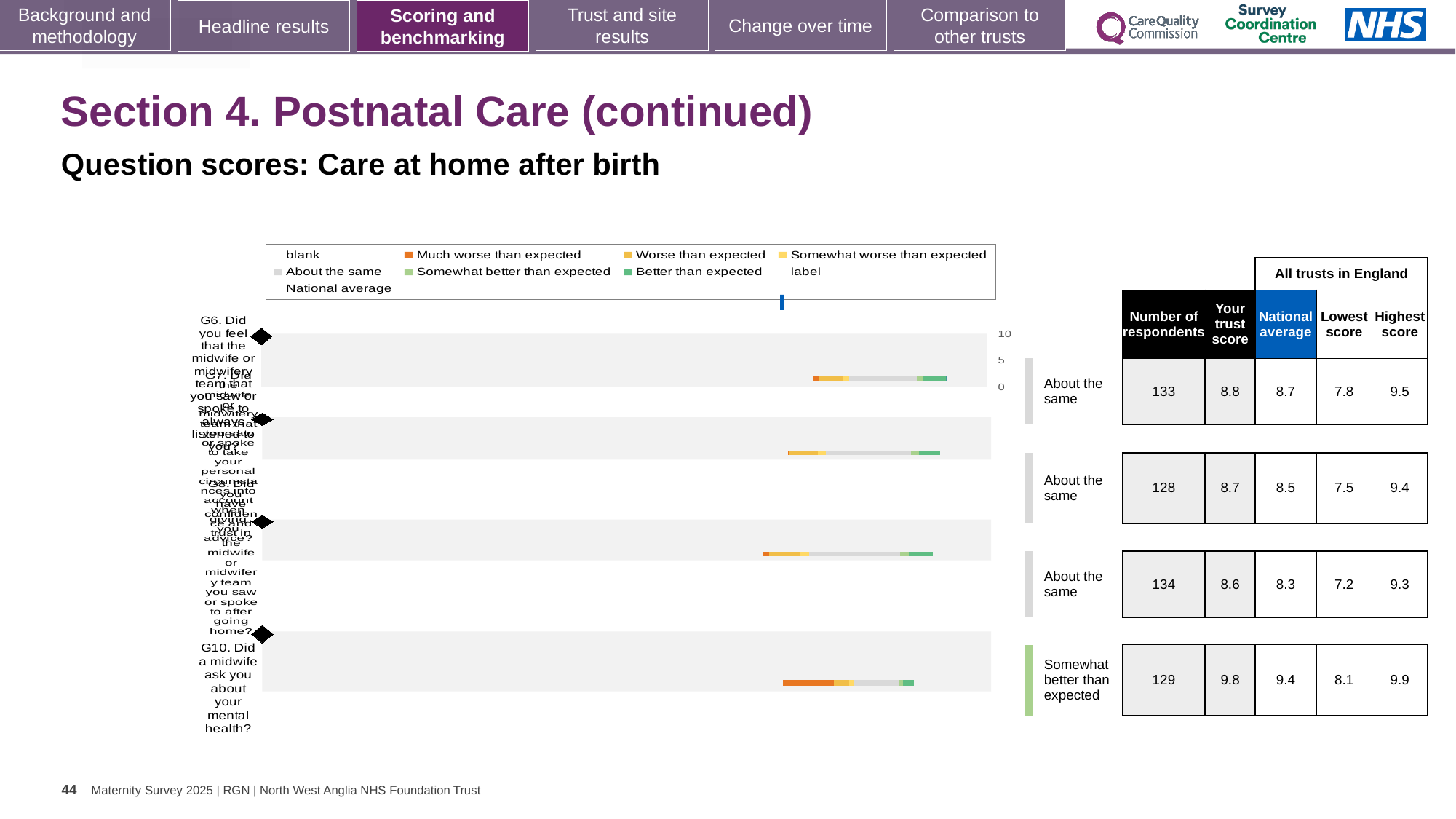
What is the trust score for G10 'Did a midwife ask you about your mental health?' 9.8 How many respondents answered G10 'Did a midwife ask you about your mental health?' 129 What type of chart is shown on the slide? bar chart What is the national average for G10 'Did a midwife ask you about your mental health?' 9.4 Which question is rated 'Somewhat better than expected'? G10. Did a midwife ask you about your mental health? What is the maximum value shown on the chart's score axis? 10 How many question bars are plotted in the chart? 4 Is the trust score for G10 (mental health) larger or smaller than its national average? larger What colour in the legend represents 'Much worse than expected'? orange By how much does the trust score for G10 (mental health) exceed the national average? 0.4 What is the highest score among all trusts in England for G10 'Did a midwife ask you about your mental health?' 9.9 Which question has the highest trust score? G10. Did a midwife ask you about your mental health?